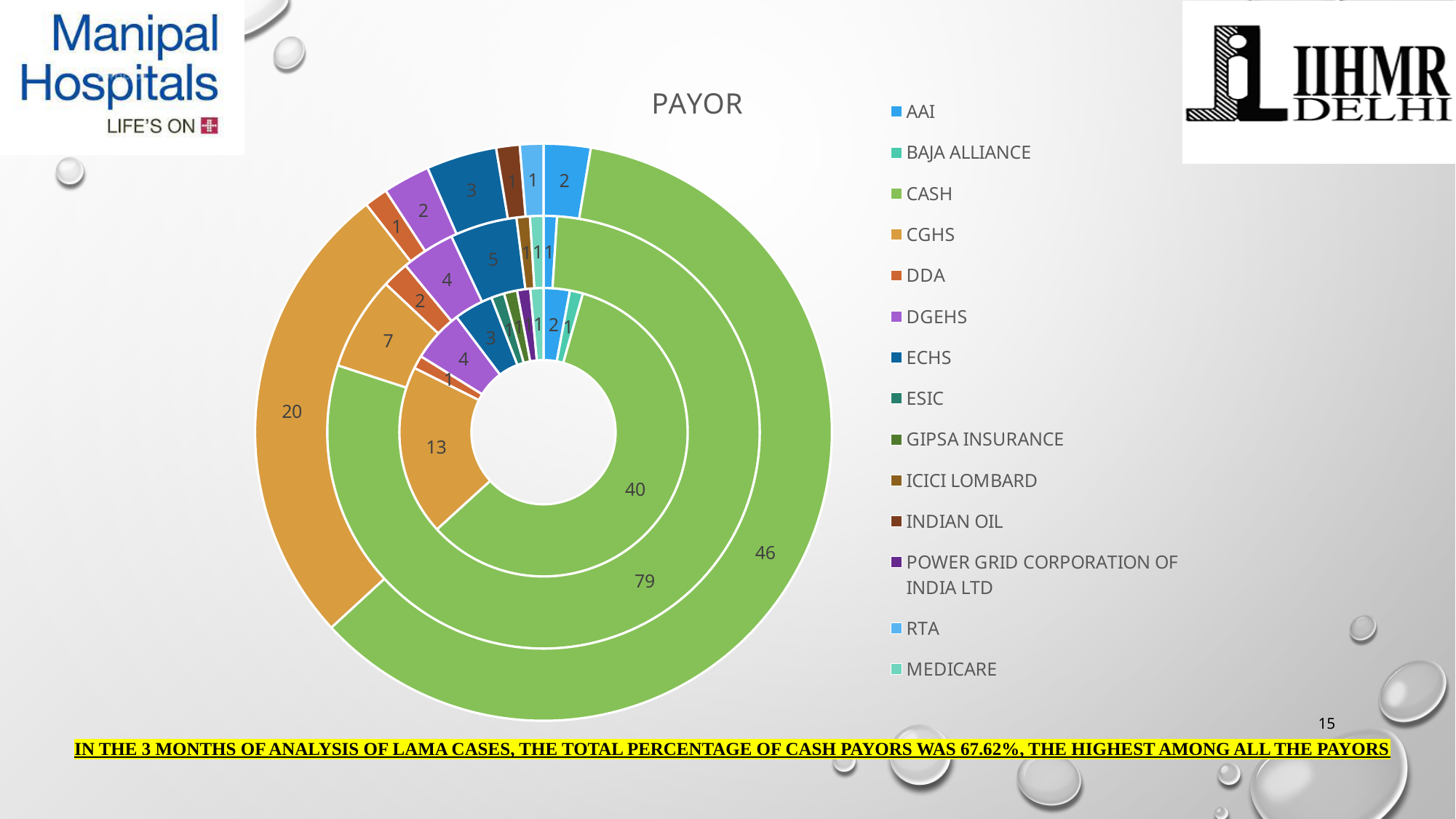
Which payor has the largest segment in the outer ring? CASH How many payor categories does the legend list? 14 What is the value of the CGHS segment in the inner ring? 13 What is the value of the CGHS segment in the outer ring? 20 What is the value of the CASH segment in the inner ring? 40 What is the title of the chart? PAYOR What is the value of the CASH segment in the outer ring? 46 What is the value of the CASH segment in the middle ring? 79 In the outer ring, which is larger: the ECHS segment or the DGEHS segment? ECHS How many concentric rings does the doughnut chart have? 3 What type of chart is shown on the slide? Doughnut chart What is the difference between the CASH and CGHS values in the middle ring? 72